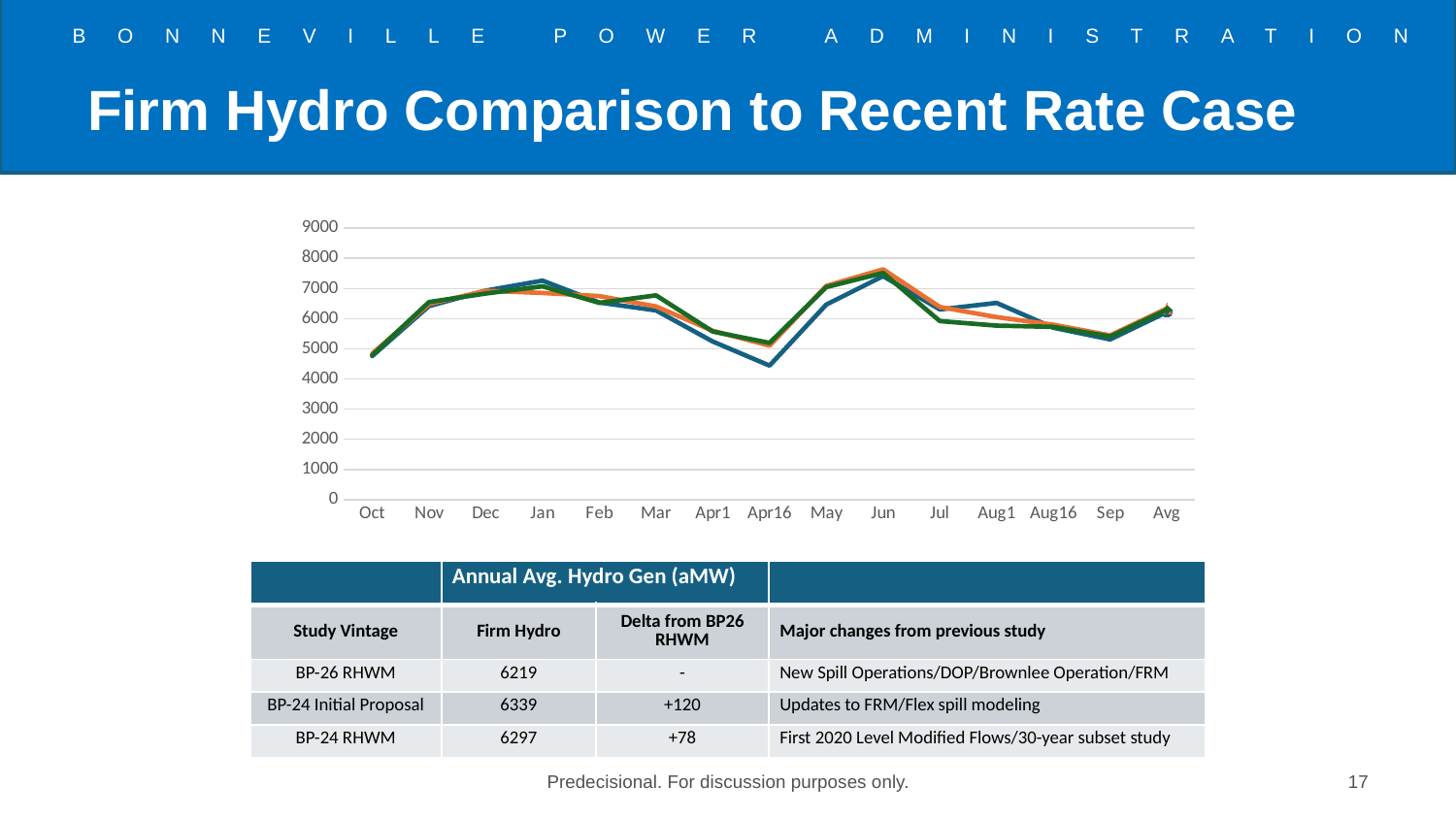
How many categories are shown along the x axis of the chart? 15 Do the values rise or fall from Jun to Sep? fall Which category has the highest value on the chart? Jun Is the value of the blue line for Apr16 greater or less than 5000? less For the blue line, which category has the lowest value? Apr16 Is the value for Nov greater or less than 6000? greater What kind of chart is shown on the slide? line chart What is the highest value shown on the y axis of the chart? 9000 How many lines are plotted on the chart? 3 Is the value for Sep greater or less than 6000? less